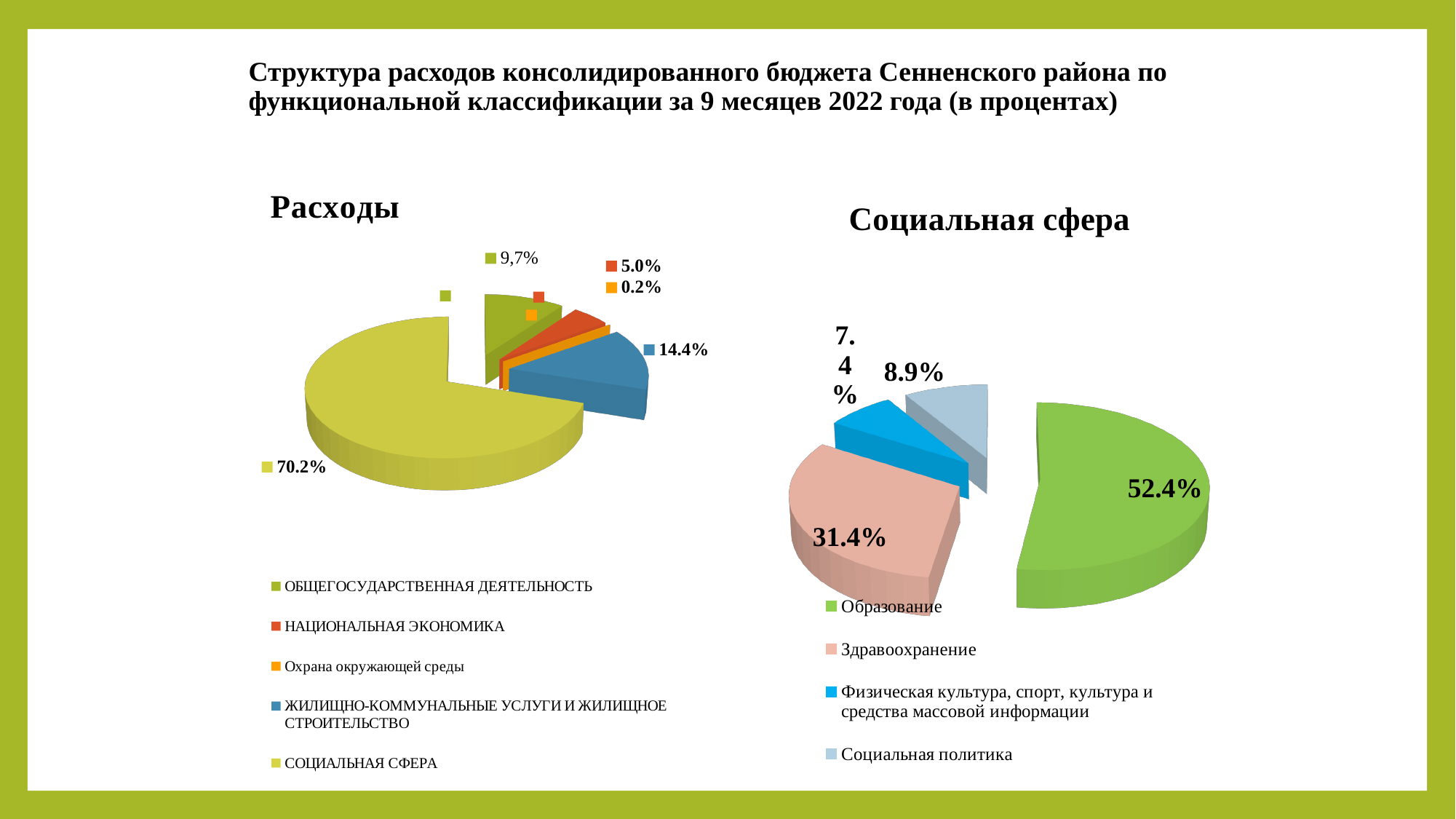
In the 'Социальная сфера' chart, which is larger: Социальная политика or Физическая культура, спорт, культура и средства массовой информации? Социальная политика In the 'Расходы' chart, which category has the largest share? СОЦИАЛЬНАЯ СФЕРА In the 'Расходы' chart, what share is shown for СОЦИАЛЬНАЯ СФЕРА? 70.2% In the 'Расходы' chart, which category has the smallest share? Охрана окружающей среды In the 'Социальная сфера' chart, which category has the largest share? Образование In the 'Социальная сфера' chart, what share is shown for Здравоохранение? 31.4% In the 'Социальная сфера' chart, what share is shown for Социальная политика? 8.9% In the 'Расходы' chart, what share is shown for ЖИЛИЩНО-КОММУНАЛЬНЫЕ УСЛУГИ И ЖИЛИЩНОЕ СТРОИТЕЛЬСТВО? 14.4% In the 'Социальная сфера' chart, what is the difference between the shares of Образование and Здравоохранение? 21.0% What type of chart is the 'Социальная сфера' chart? Pie chart In the 'Расходы' chart, what share is shown for НАЦИОНАЛЬНАЯ ЭКОНОМИКА? 5.0% In the 'Расходы' chart, how many categories does the legend list? 5